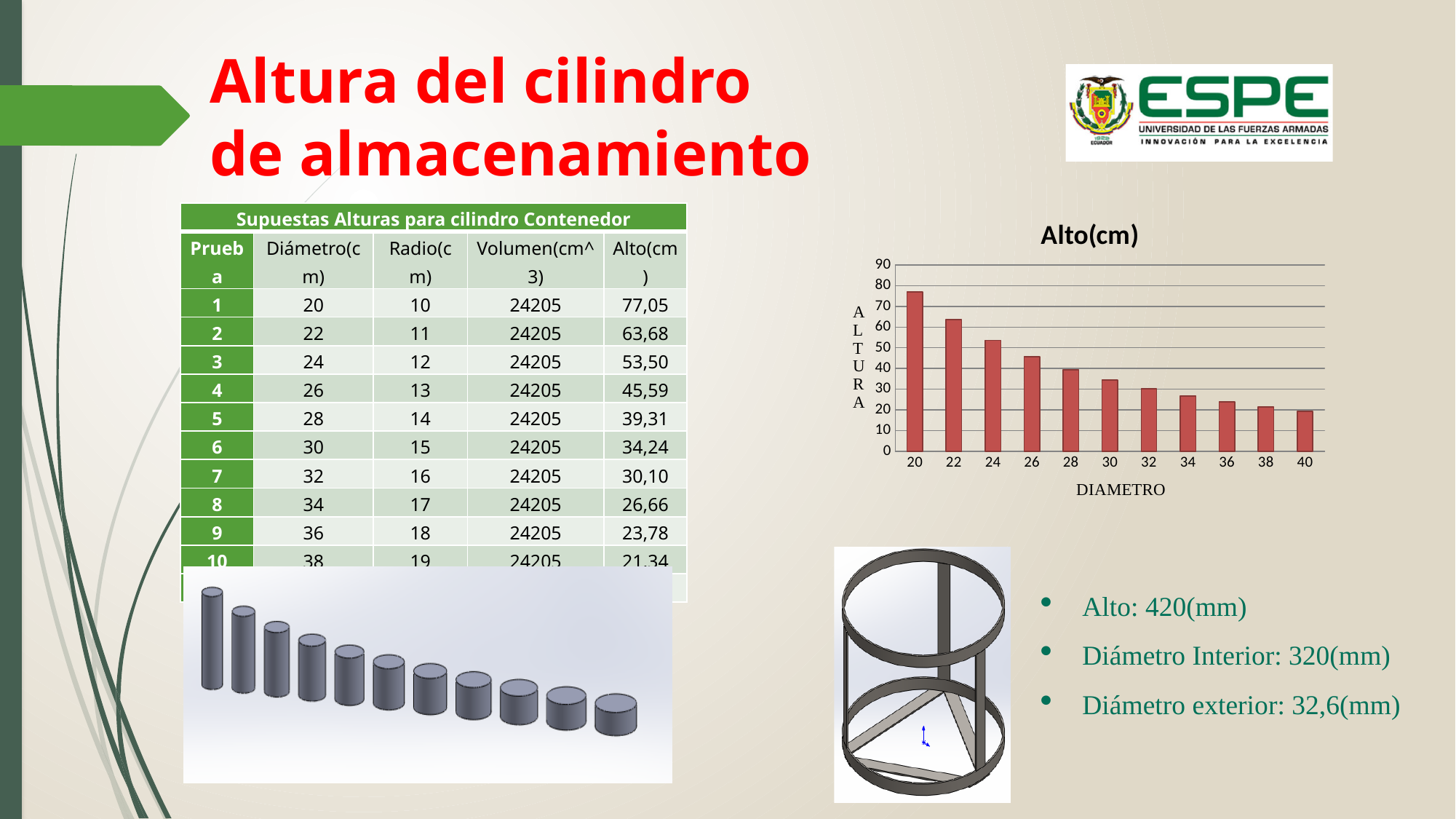
What is the label on the x axis of the Alto(cm) chart? DIAMETRO Is the value for diameter 36 greater or less than 30? less How many diameter categories are plotted on the x axis of the Alto(cm) chart? 11 Is the value for diameter 24 greater or less than 50? greater Which diameter has the lowest bar in the Alto(cm) chart? 40 Do the bar values rise or fall as the diameter increases along the x axis? fall Which diameter has the highest bar in the Alto(cm) chart? 20 What kind of chart is shown under the title Alto(cm)? bar chart Is the value for diameter 20 greater or less than 70? greater What is the title of the bar chart? Alto(cm) Which has the larger bar, diameter 22 or diameter 30? 22